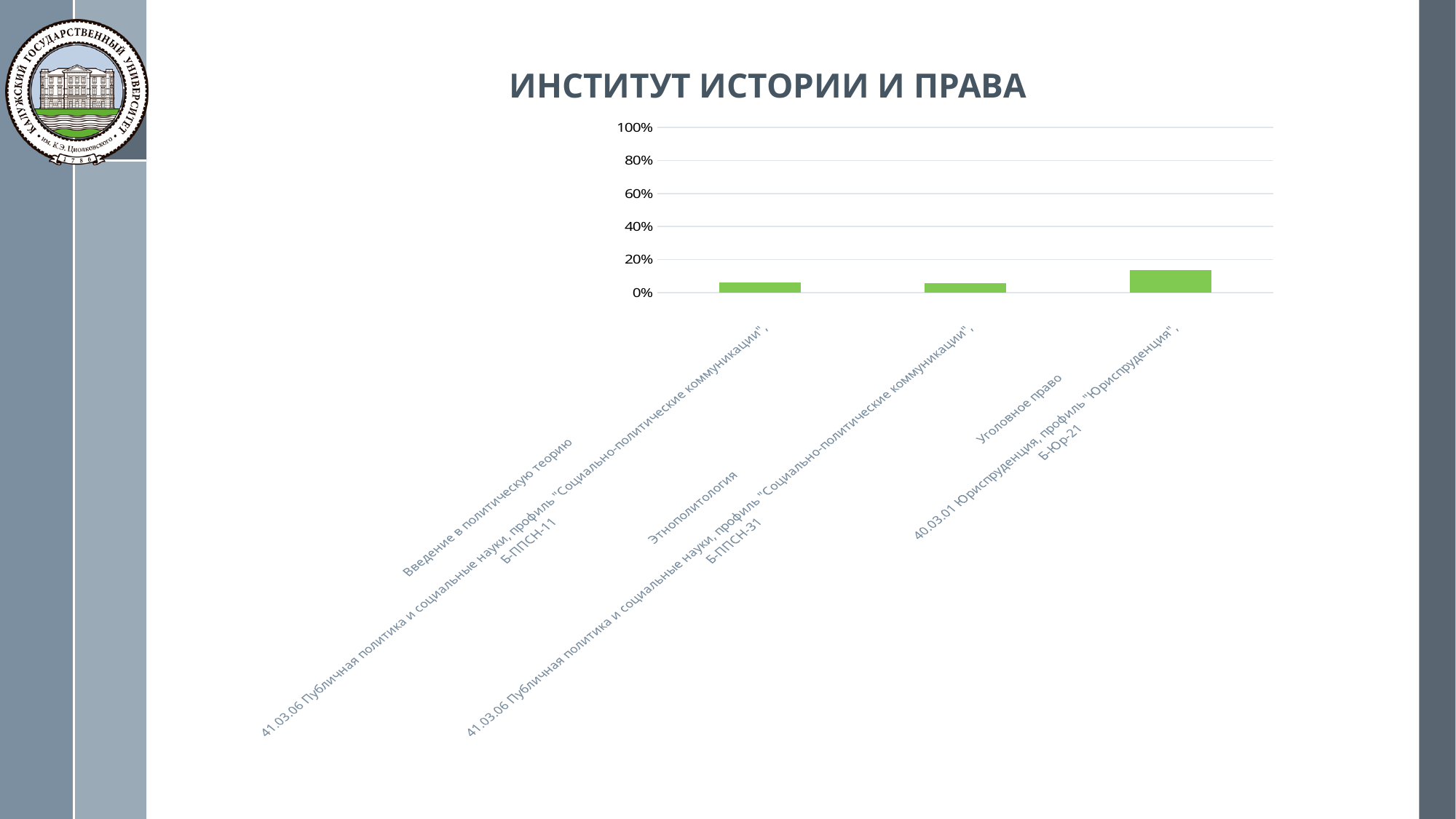
How many categories (bars) are plotted in the chart? 3 Which is larger: the value for Уголовное право or the value for Введение в политическую теорию? Уголовное право What is the title of the slide above the chart? ИНСТИТУТ ИСТОРИИ И ПРАВА Is the value for Введение в политическую теорию greater or less than 20%? less Is the value for Уголовное право greater or less than 20%? less Is the value for Уголовное право greater or less than 40%? less What kind of chart is shown on the slide? bar chart Which is larger: the value for Уголовное право or the value for Этнополитология? Уголовное право Which category has the highest value in the chart? Уголовное право What is the highest value shown on the vertical axis of the chart? 100%